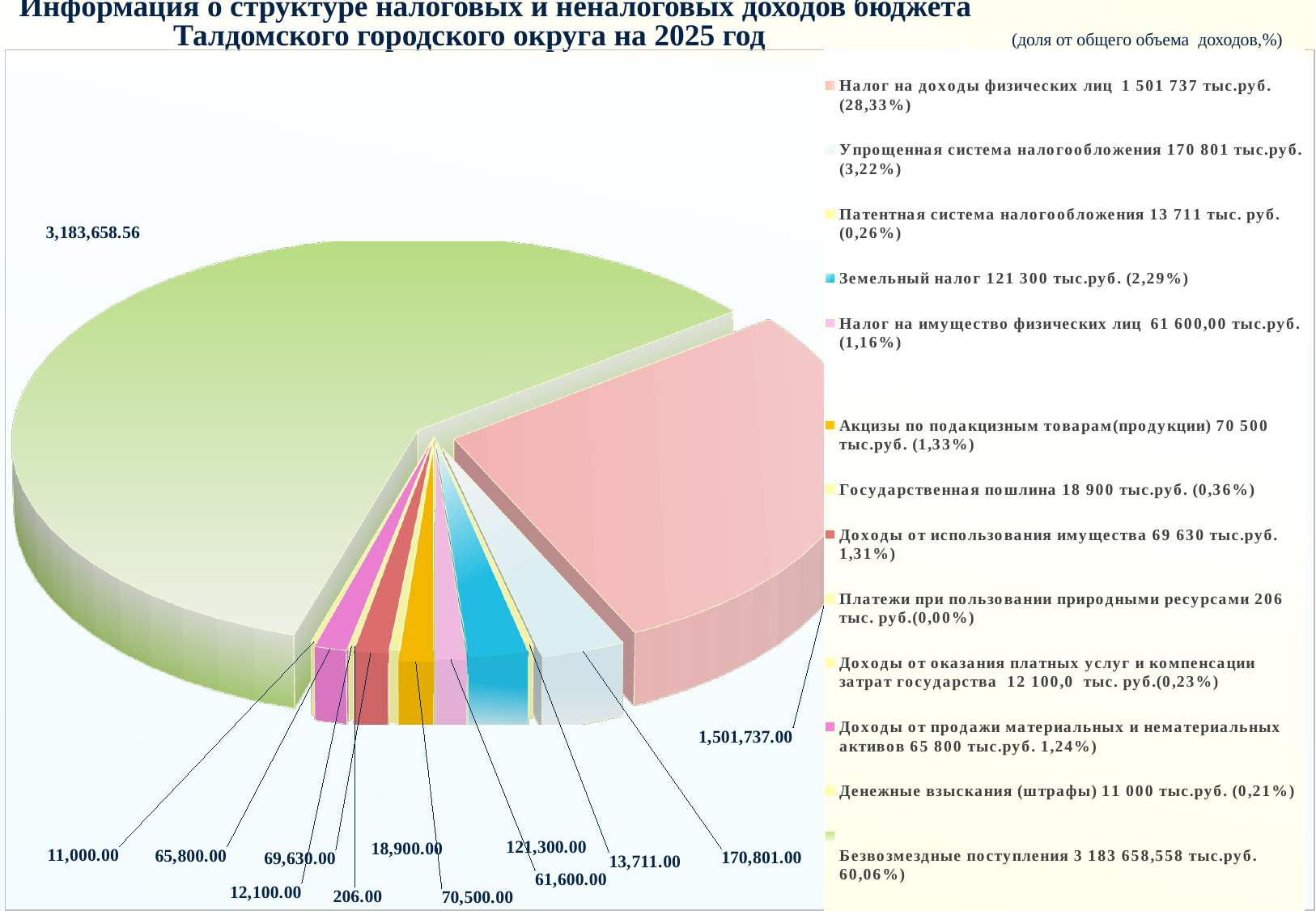
What value is labelled on the slice for Акцизы по подакцизным товарам (продукции)? 70,500.00 Which category has the smallest slice of the pie? Платежи при пользовании природными ресурсами Which is larger: Упрощенная система налогообложения or Земельный налог? Упрощенная система налогообложения What value is labelled on the slice for Налог на доходы физических лиц? 1,501,737.00 What kind of chart is shown on the slide? pie chart What is the difference between the labelled values for Налог на доходы физических лиц (1,501,737.00) and Упрощенная система налогообложения (170,801.00)? 1,330,936.00 What colour is the largest slice of the pie? green How many slices does the pie chart have? 13 According to the legend, what share of total revenue is Безвозмездные поступления? 60,06% Which category has the largest slice of the pie? Безвозмездные поступления According to the legend, what share of total revenue is Земельный налог? 2,29% How many entries does the legend list? 13